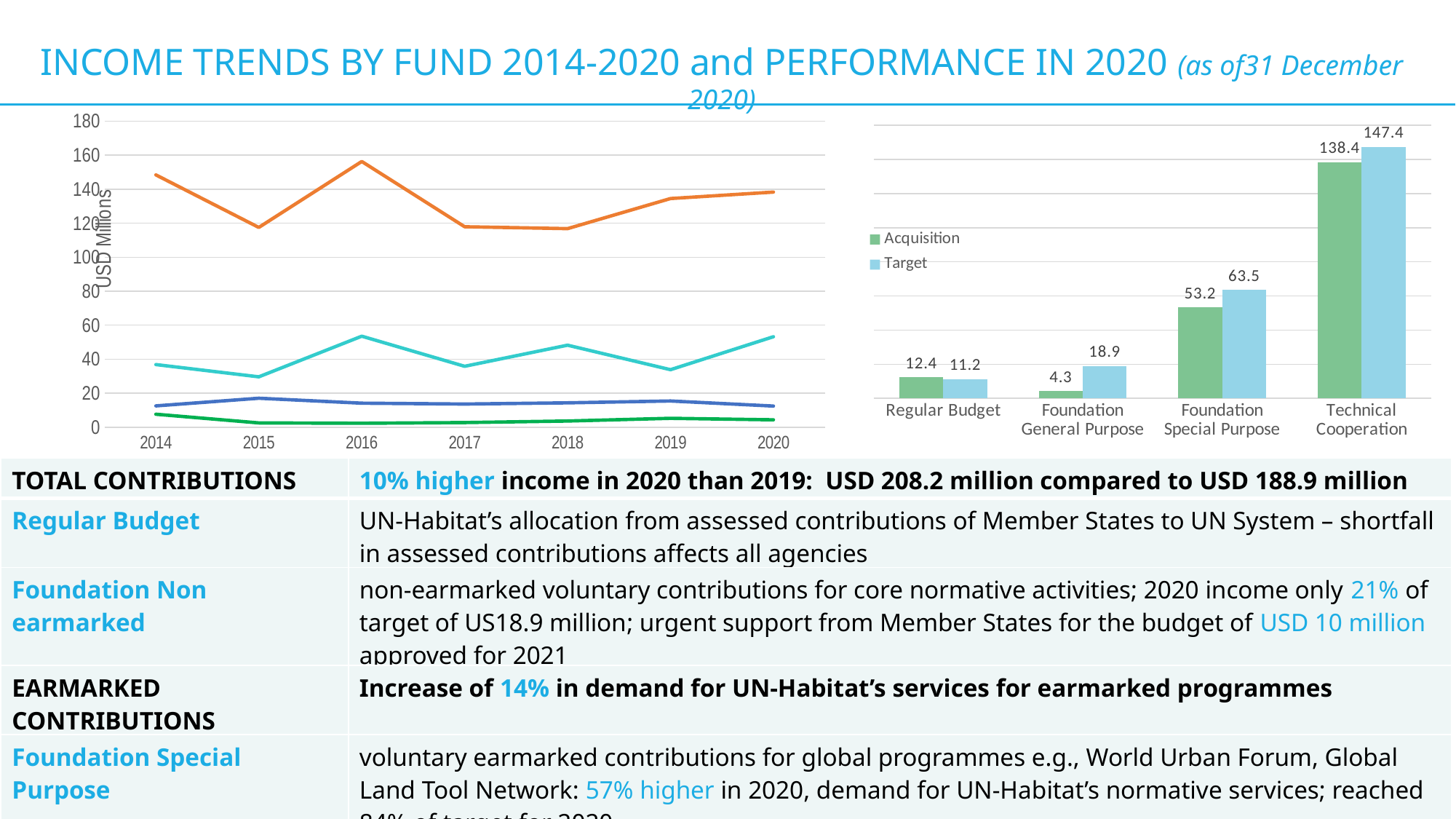
In the bar chart on the right, what is the difference between the Target and Acquisition values for Foundation Special Purpose? 10.3 In the line chart on the left, is the value of the orange line in 2016 greater or less than 140? greater What kind of chart is the chart on the right of the slide? bar chart In the bar chart on the right, which category has the highest Target value? Technical Cooperation In the bar chart on the right, what is the Acquisition value for Technical Cooperation? 138.4 How many years are shown on the x axis of the line chart on the left? 7 In the bar chart on the right, what is the Target value for Foundation General Purpose? 18.9 How many categories are shown in the bar chart on the right? 4 How many series does the legend of the bar chart on the right list? 2 In the bar chart on the right, which category has the lowest Acquisition value? Foundation General Purpose In the bar chart on the right, which is larger for Regular Budget, Acquisition or Target? Acquisition What kind of chart is the chart on the left of the slide? line chart